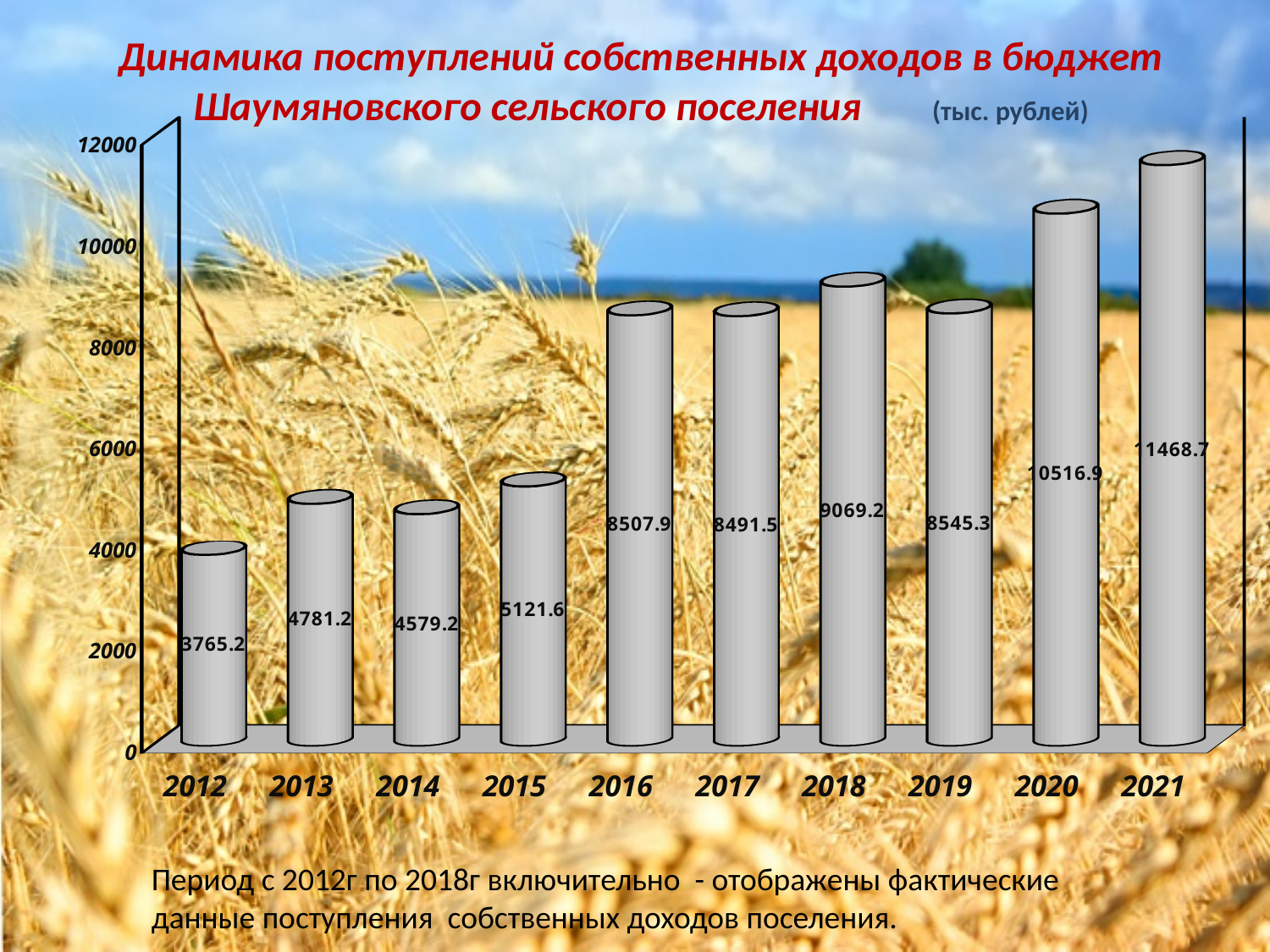
What is the difference between the values for 2021 and 2020? 951.8 Do the values generally rise or fall from 2012 to 2021? rise What is the value for 2020? 10516.9 What kind of chart is shown on the slide? bar chart Which year has the highest value? 2021 What is the value for 2012? 3765.2 Which year has the lowest value? 2012 What is the value for 2018? 9069.2 Which is larger, the value for 2013 or the value for 2014? 2013 How many years are shown on the x axis? 10 Is the value for 2021 greater or less than 10000? greater What is the difference between the values for 2018 and 2019? 523.9